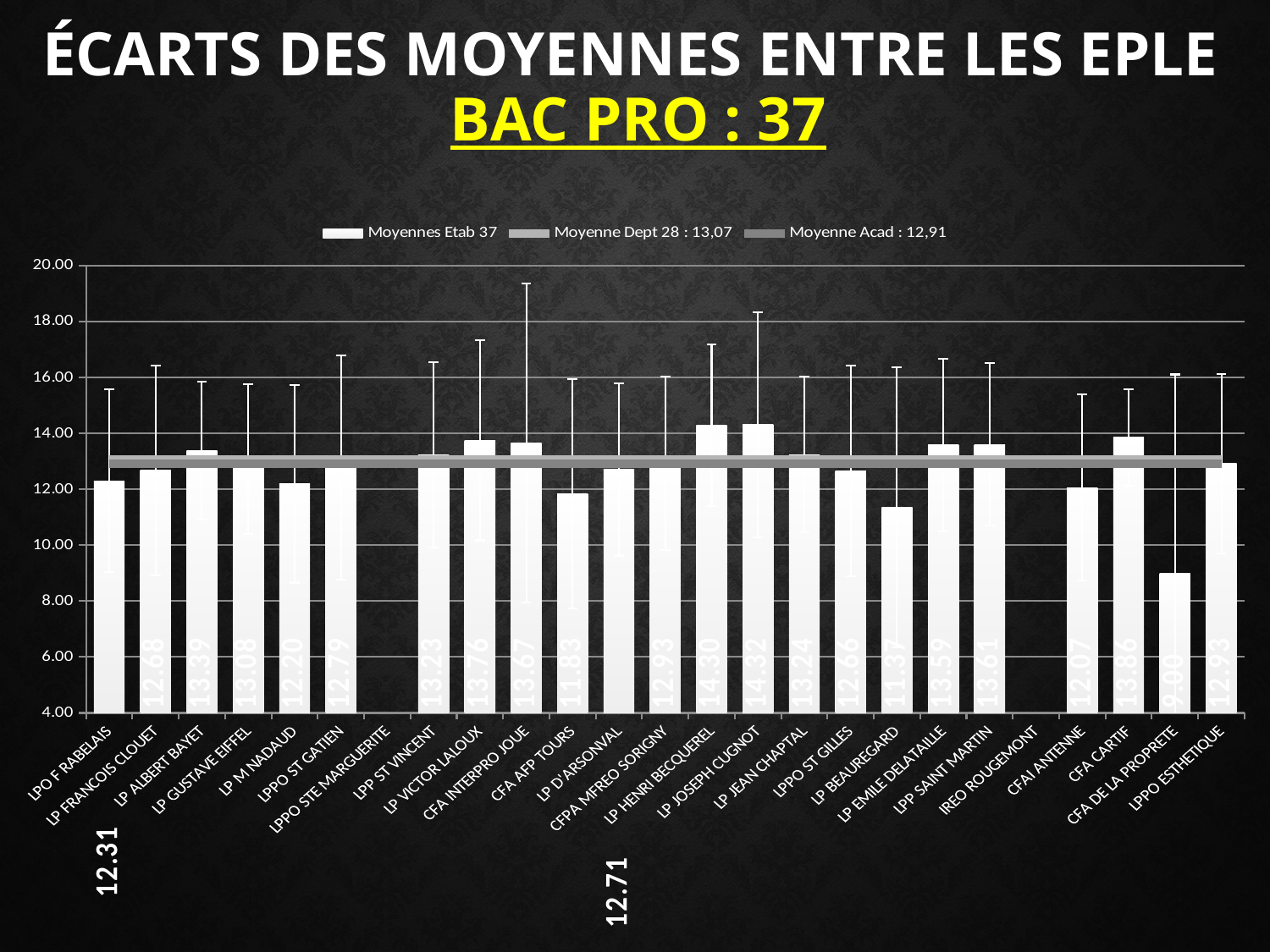
What is the difference between the values for LP VICTOR LALOUX and CFA AFP TOURS? 1.93 Which establishment has the lowest value? CFA DE LA PROPRETE What value does the legend give for Moyenne Dept 28? 13,07 What value does the legend give for Moyenne Acad? 12,91 What is the value for LPP SAINT MARTIN? 13.61 Which has the larger value, LP BEAUREGARD or LP M NADAUD? LP M NADAUD What is the value for LP ALBERT BAYET? 13.39 What is the value for CFA DE LA PROPRETE? 9.00 What kind of chart is shown on the slide? bar chart How many series does the legend list? 3 Is the value for CFA DE LA PROPRETE greater or less than 10.00? less What is the value for LP HENRI BECQUEREL? 14.30